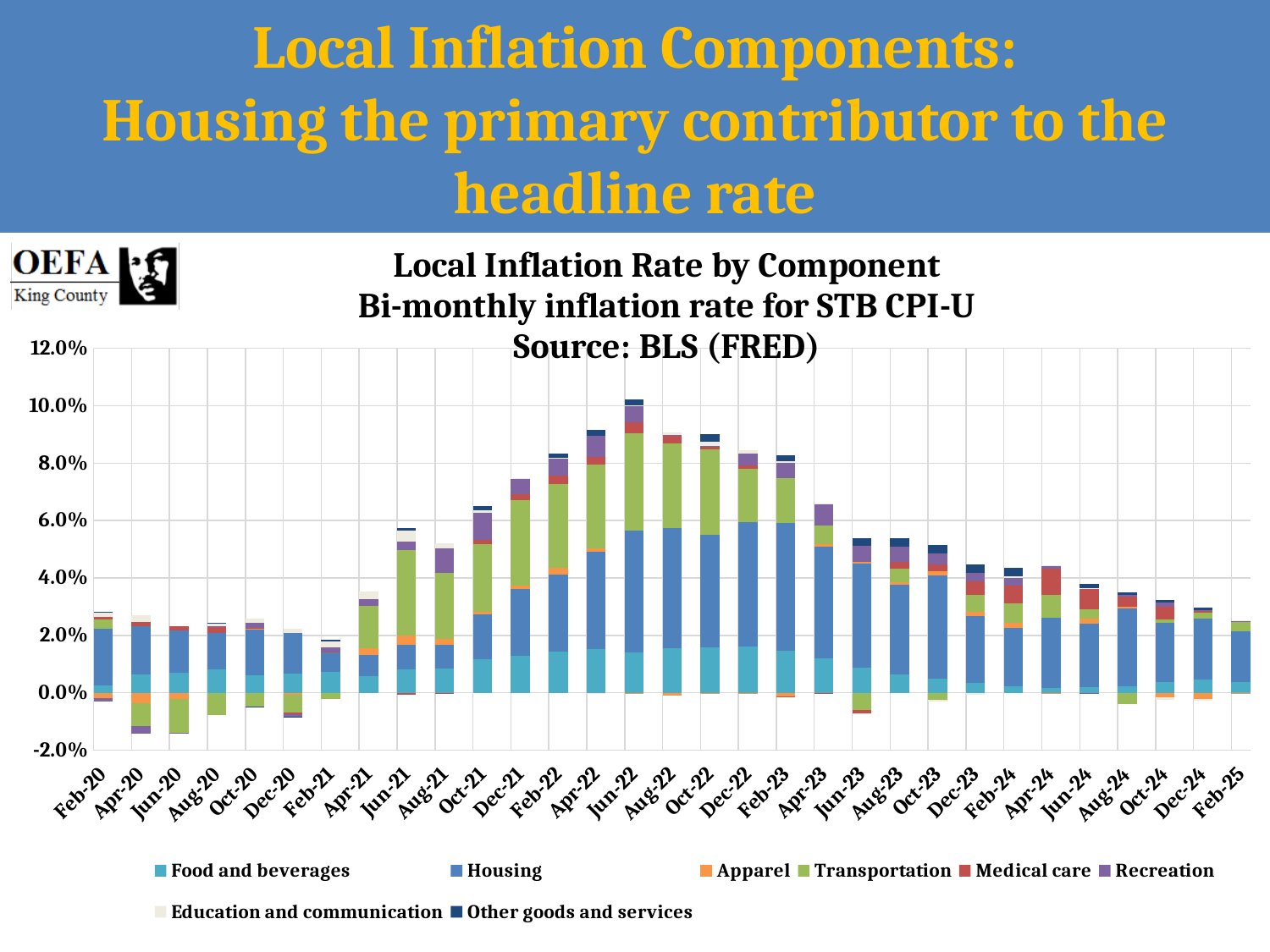
Which period has the tallest stacked bar? Jun-22 Is the total stacked value for Feb-25 greater or less than 4.0%? less Do the total stacked values generally rise or fall from Jun-22 to Feb-25? Fall What kind of chart is shown on the slide? Stacked bar chart Which period has the larger total stacked value, Jun-22 or Feb-20? Jun-22 Is the total stacked value for Aug-24 greater or less than 4.0%? less Is the total stacked value for Apr-22 greater or less than 8.0%? greater Which series is shown in the dark blue colour that makes up most of each bar? Housing How many bi-monthly periods (bars) are plotted along the x axis? 31 What is the title of the chart? Local Inflation Rate by Component How many series does the legend list? 8